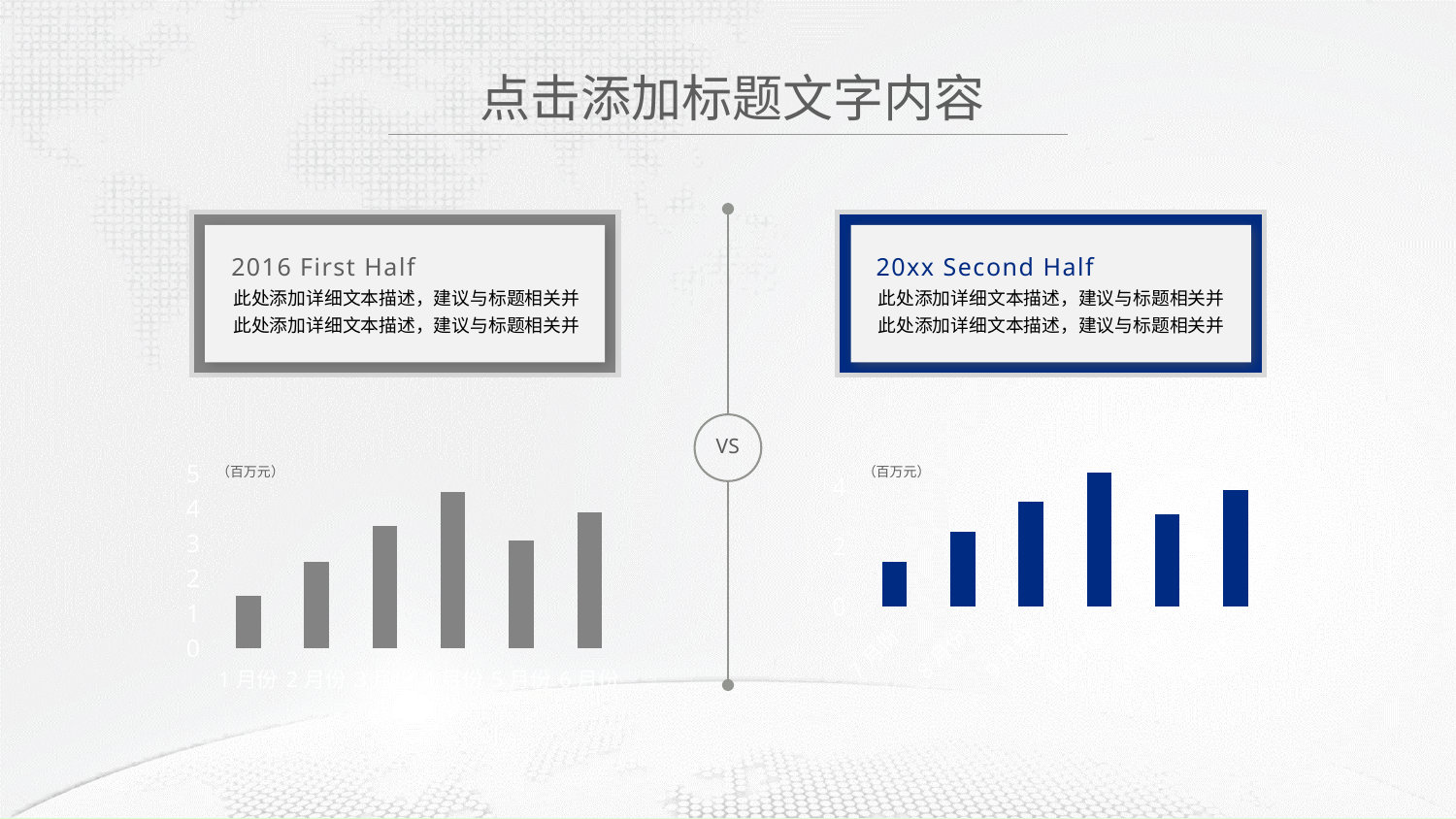
How many bars does the left chart have? 6 In the right chart, which bar is the tallest, counting from the left? the fourth bar What kind of chart is shown on the right side of the slide? bar chart In the left chart, which month has the lowest bar? 1月份 What kind of chart is shown on the left side of the slide? bar chart In the left chart, is the value for 1月份 greater or less than 2? less In the left chart, is the value for 4月份 greater or less than 4? greater In the left chart, which is larger, the value for 4月份 or the value for 1月份? 4月份 In the right chart, is the value of the first bar greater or less than 2? less In the left chart, which month has the highest bar? 4月份 How many bars does the right chart have? 6 What unit is shown above the y axis of the left chart? (百万元)